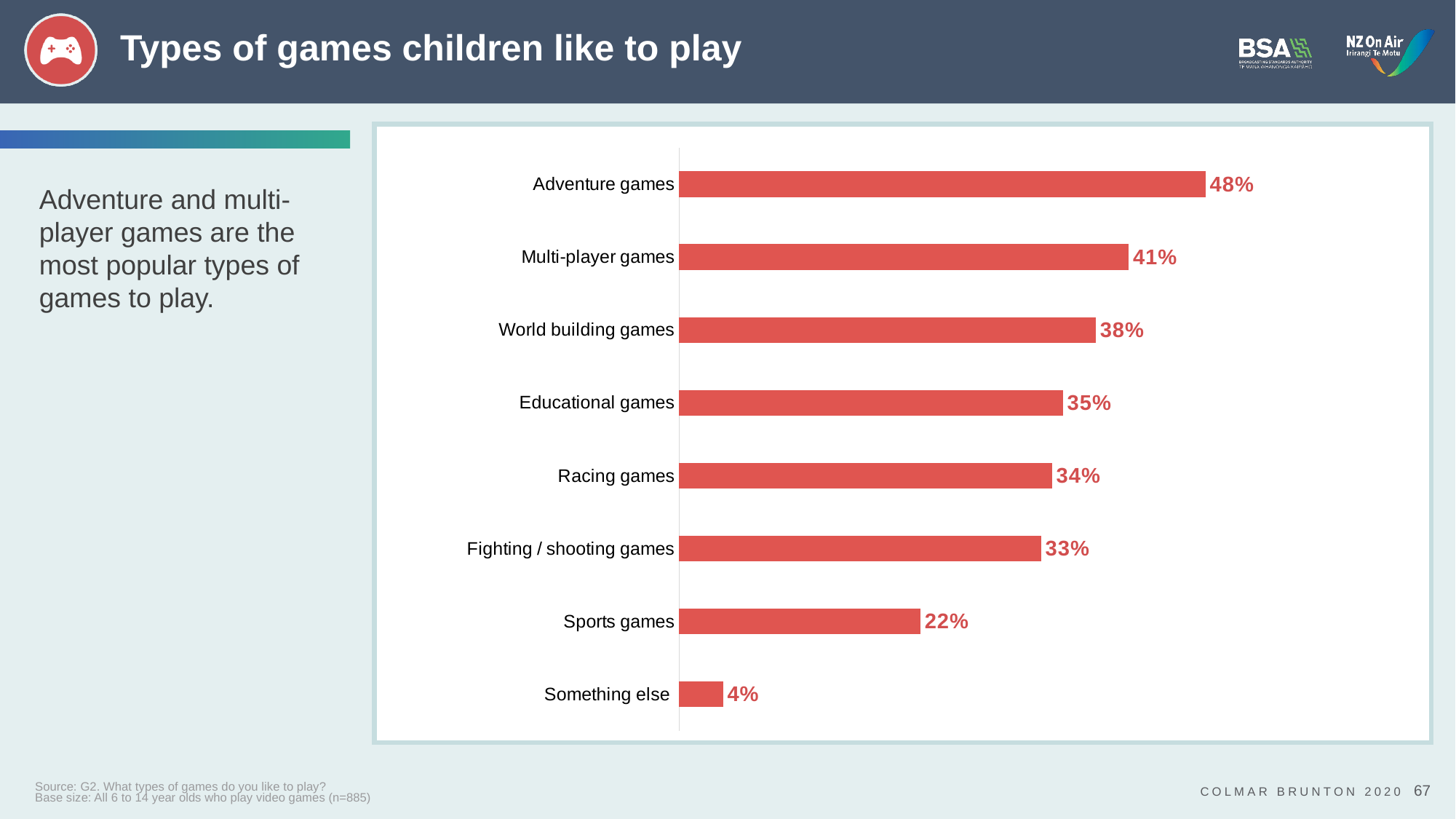
What kind of chart is shown on the slide? Bar chart How many game types are shown on the chart? 8 Which has a higher value, World building games or Racing games? World building games What percentage is shown for Educational games? 35% Which has a higher value, Fighting / shooting games or Sports games? Fighting / shooting games Which category has the lowest value on the chart? Something else What is the difference between the values for Sports games and Something else? 18% What is the title of the slide? Types of games children like to play What is the difference between the values for Adventure games and Multi-player games? 7% What percentage of children like to play adventure games? 48% Which type of game has the highest percentage? Adventure games What is the value shown for Sports games? 22%